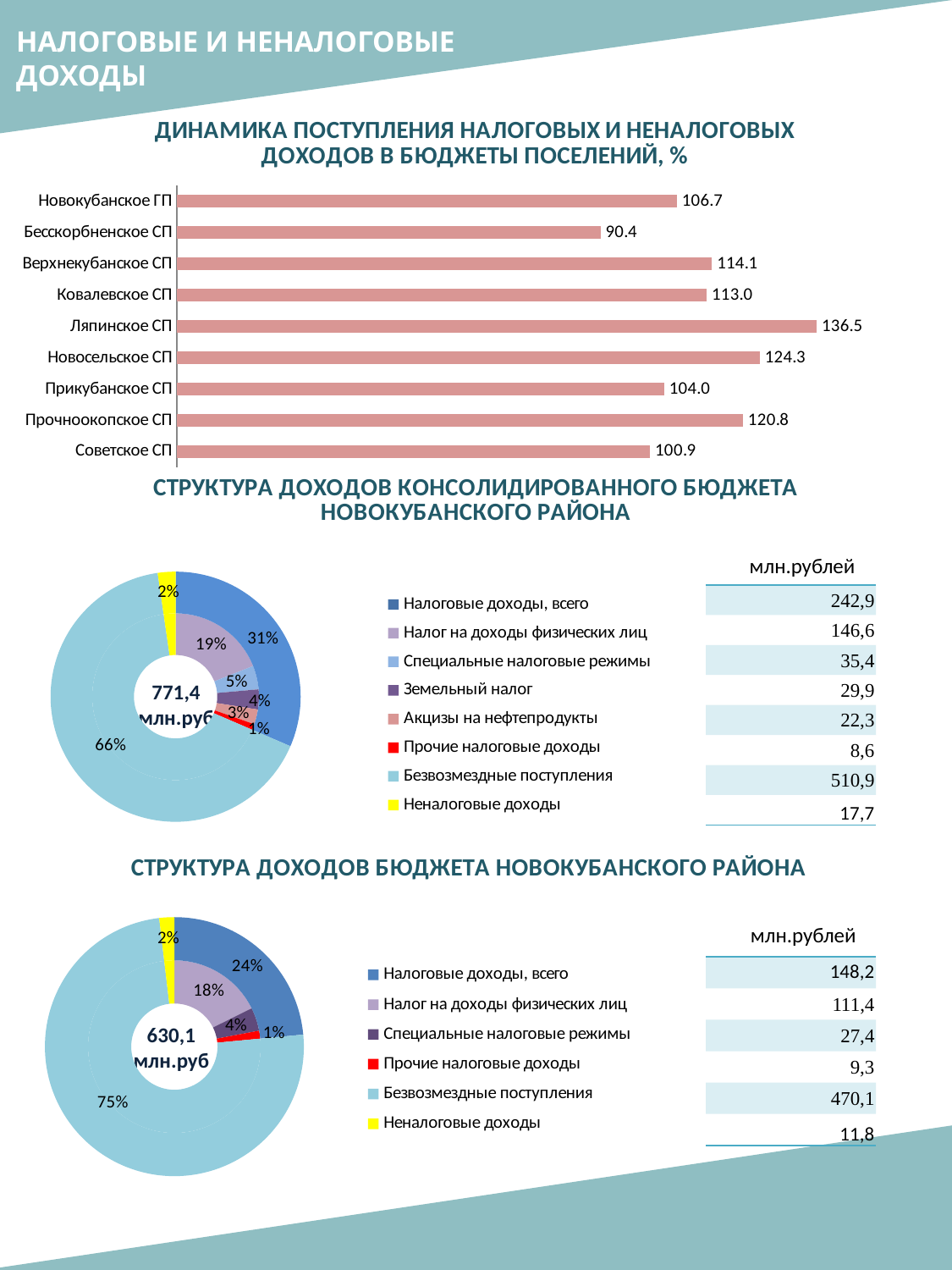
What total value is shown in the centre of the doughnut chart 'Структура доходов бюджета Новокубанского района'? 630,1 млн.руб In the bar chart 'Динамика поступления налоговых и неналоговых доходов в бюджеты поселений, %', which settlement has the highest value? Ляпинское СП In the bar chart 'Динамика поступления налоговых и неналоговых доходов в бюджеты поселений, %', what is the difference between Новосельское СП and Прикубанское СП? 20.3 In the chart 'Структура доходов бюджета Новокубанского района', what share of the pie is Налоговые доходы, всего? 24% In the bar chart 'Динамика поступления налоговых и неналоговых доходов в бюджеты поселений, %', which is larger: Верхнекубанское СП or Ковалевское СП? Верхнекубанское СП In the chart 'Структура доходов консолидированного бюджета Новокубанского района', what is the value in млн.рублей for Налоговые доходы, всего? 242,9 In the bar chart 'Динамика поступления налоговых и неналоговых доходов в бюджеты поселений, %', what is the value for Ляпинское СП? 136.5 How many entries does the legend list for the chart 'Структура доходов консолидированного бюджета Новокубанского района'? 8 In the bar chart 'Динамика поступления налоговых и неналоговых доходов в бюджеты поселений, %', which settlement has the lowest value? Бесскорбненское СП In the chart 'Структура доходов консолидированного бюджета Новокубанского района', what share of the pie is Безвозмездные поступления? 66% What type of chart is used for 'Динамика поступления налоговых и неналоговых доходов в бюджеты поселений, %'? Bar chart How many settlements are shown in the bar chart 'Динамика поступления налоговых и неналоговых доходов в бюджеты поселений, %'? 9